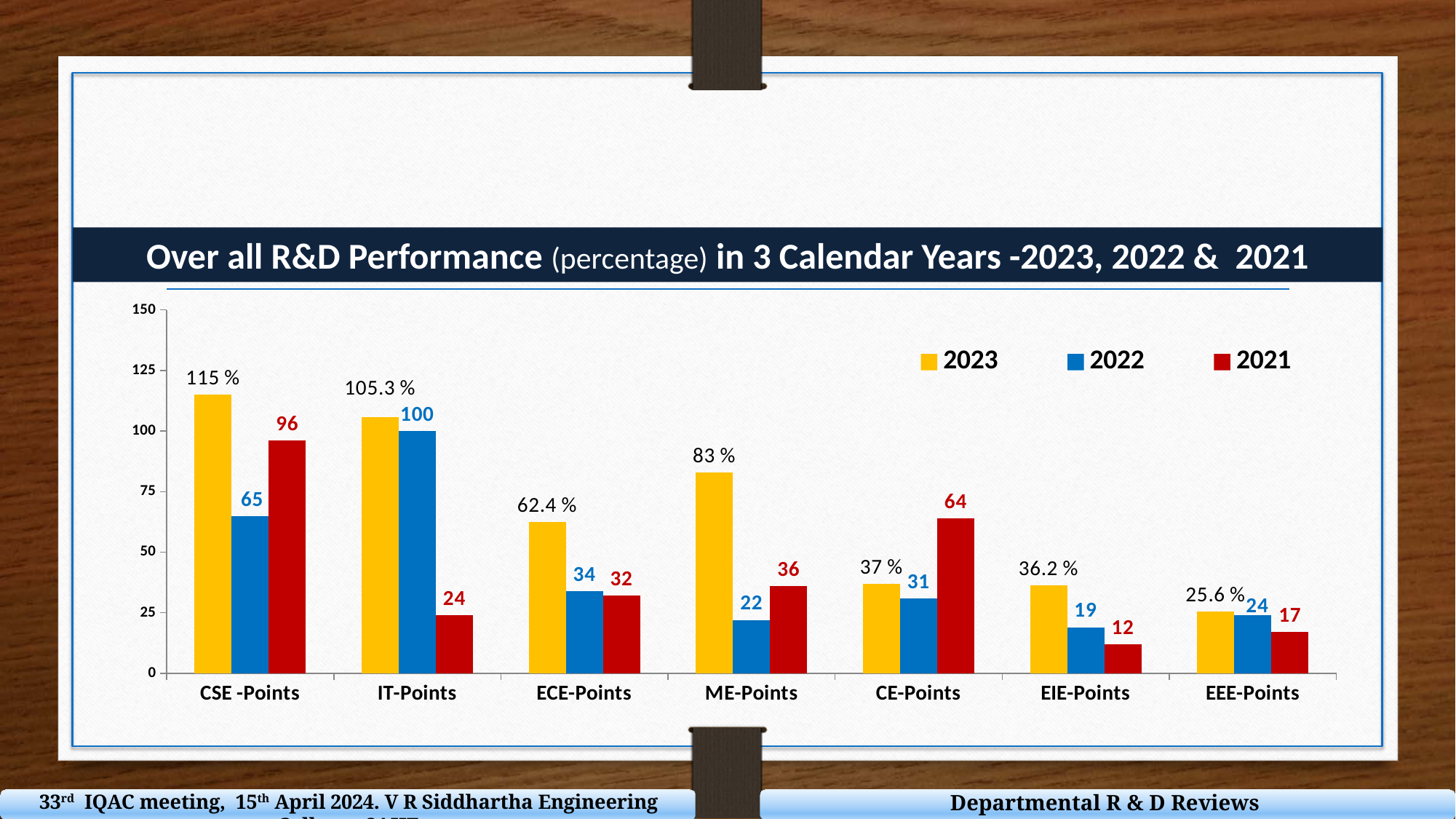
What is the 2021 value for CE-Points? 64 What is the 2023 value for EEE-Points? 25.6 % Which category has the highest 2021 value? CSE -Points Which colour represents the 2021 series in the legend? Red What is the 2023 value for CSE -Points? 115 % What kind of chart is shown on the slide? Bar chart How many series does the legend list? 3 Which category has the lowest 2022 value? EIE-Points What is the difference between the 2022 and 2021 values for ME-Points? 14 What is the 2022 value for IT-Points? 100 Which is larger for ECE-Points, the 2022 value or the 2021 value? 2022 How many categories are shown on the x axis? 7